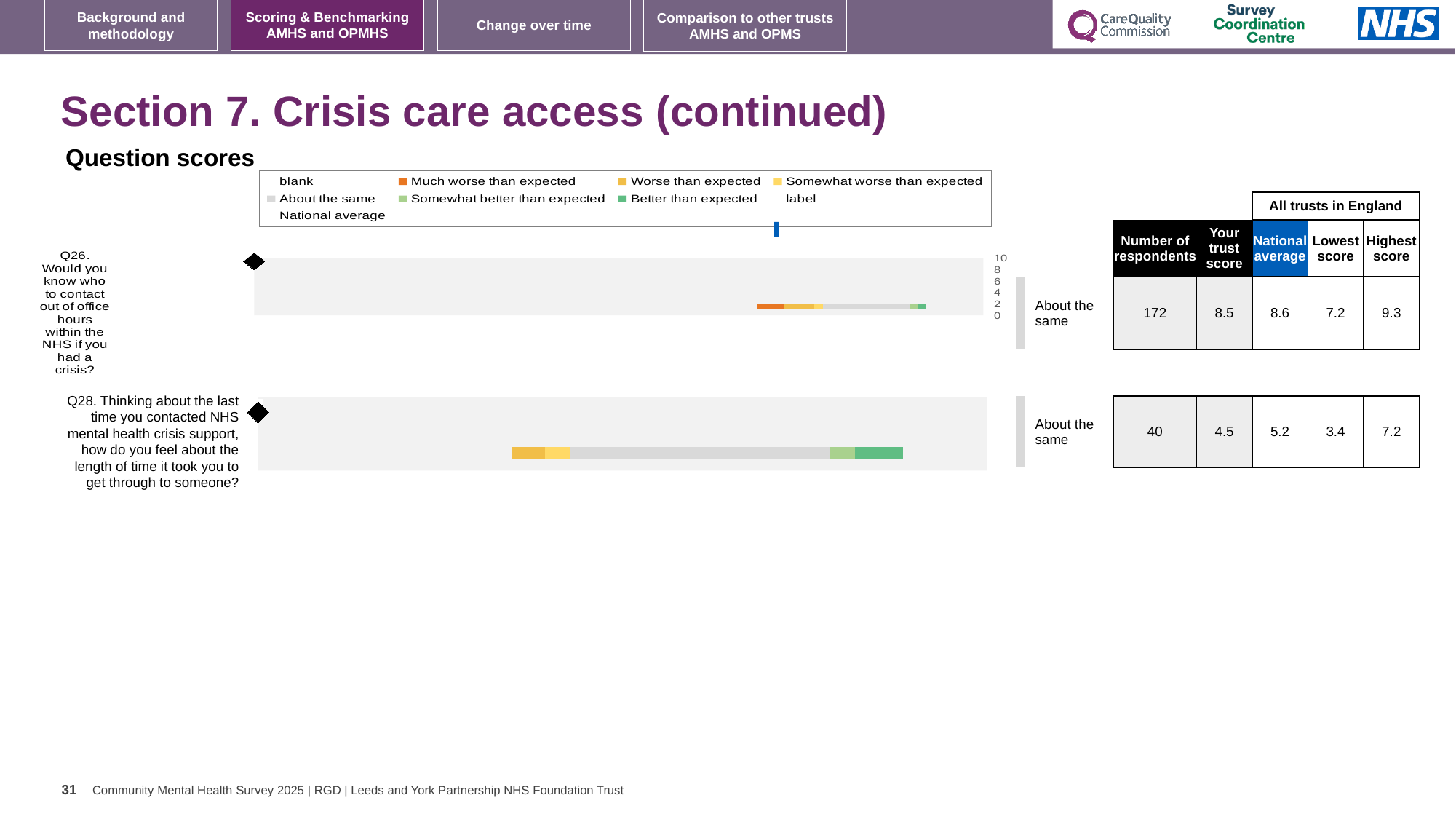
What is the highest score among all trusts in England for Q28? 7.2 What is the difference between the national average and the trust score for Q26? 0.1 What is the 'Your trust score' value for Q26 (Would you know who to contact out of office hours within the NHS if you had a crisis?)? 8.5 How many respondents answered Q28 (about the length of time it took to get through to someone)? 40 What is the difference between the highest score and the lowest score for Q28? 3.8 What is the lowest score among all trusts in England for Q26? 7.2 Is the trust score for Q28 higher or lower than the national average for Q28? Lower Which question had more respondents, Q26 or Q28? Q26 What is the national average score for Q26? 8.6 What kind of chart is used to show the question scores? Bar chart What benchmark category is shown for Q28? About the same How many questions are plotted on the slide? 2